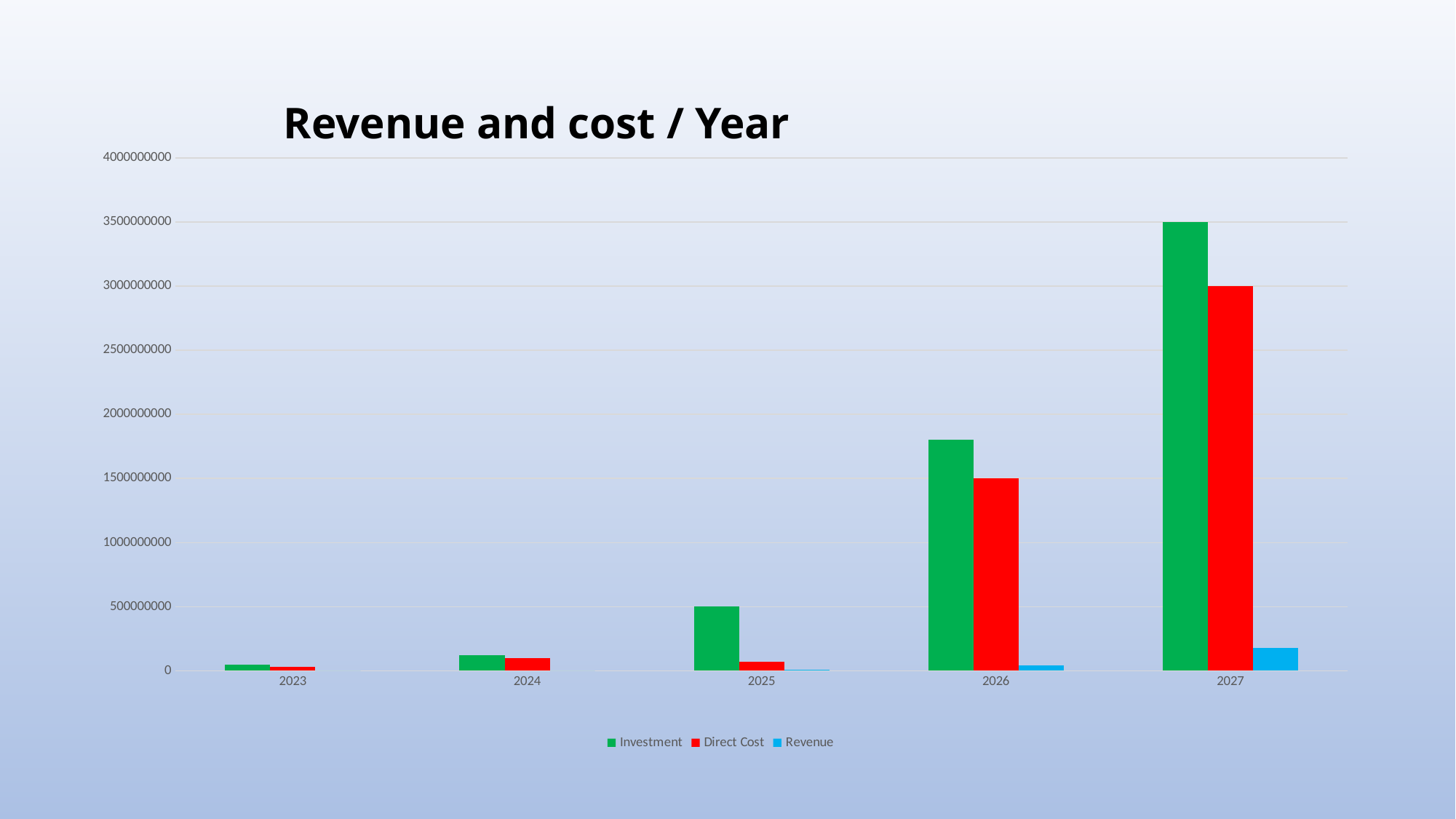
What is the Investment value for 2027? 3500000000 What is the Investment value for 2025? 500000000 Which year has the highest Investment value? 2027 How many series does the legend list? 3 Is the Investment value for 2026 greater or less than 1500000000? greater What is the Direct Cost value for 2026? 1500000000 Does the Investment value rise or fall from 2023 to 2027? rise Which is larger in 2026, Investment or Direct Cost? Investment How many years are shown on the x axis? 5 What is the title of the chart? Revenue and cost / Year What is the Direct Cost value for 2027? 3000000000 What kind of chart is shown on the slide? bar chart